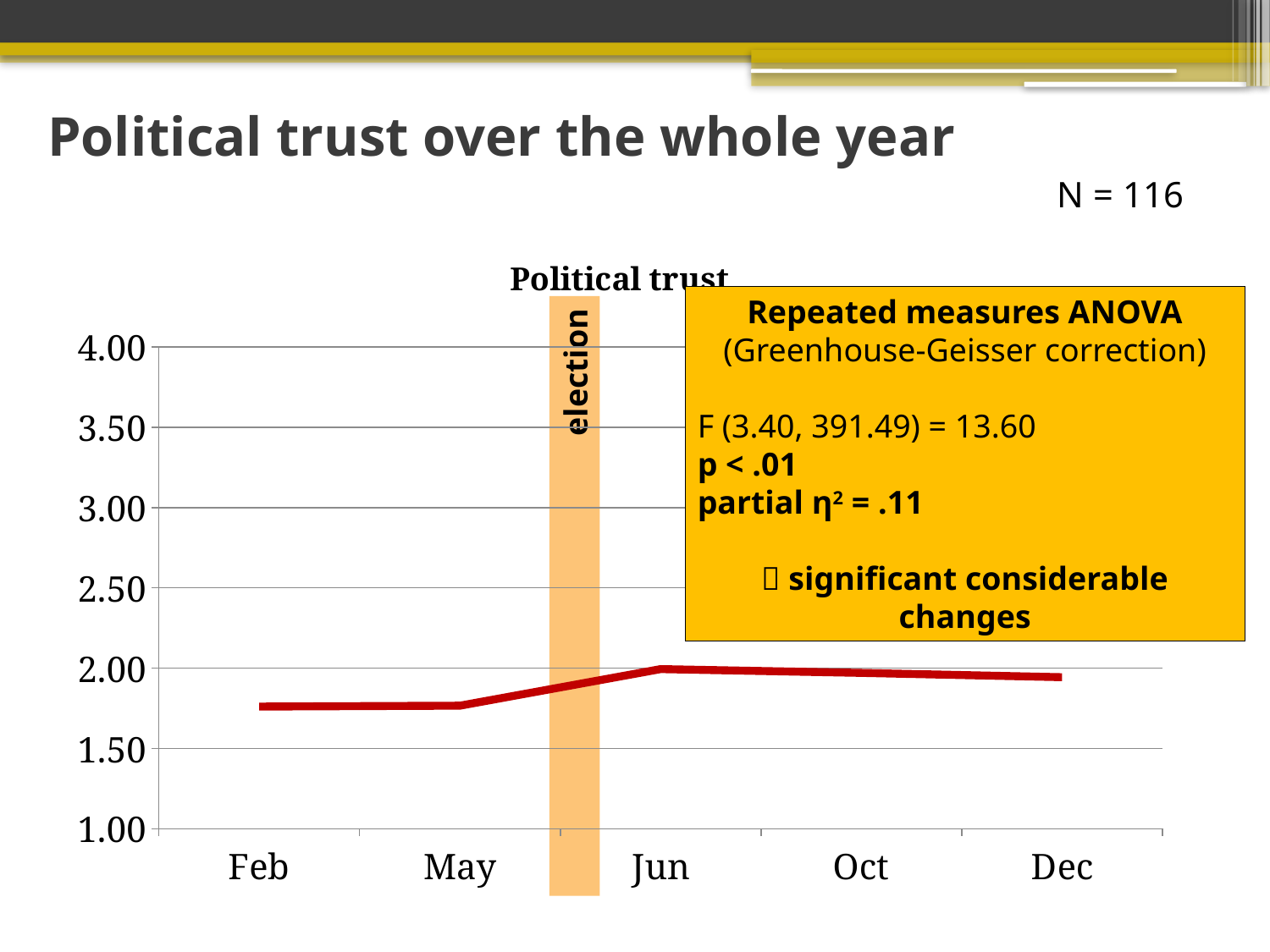
How many time points are plotted along the x axis? 5 What is the lowest value shown on the y axis? 1.00 Is the value for Feb greater or less than 2.00? less Is the value for May greater or less than 1.50? greater What is the title of the chart? Political trust Does political trust rise or fall between May and Jun? rise Which is larger, the value for May or the value for Oct? Oct What kind of chart is shown on the slide? line chart Between which two x-axis labels is the 'election' marker placed? May and Jun Is the value for Oct greater or less than 2.50? less Which is larger, the value for Jun or the value for Feb? Jun